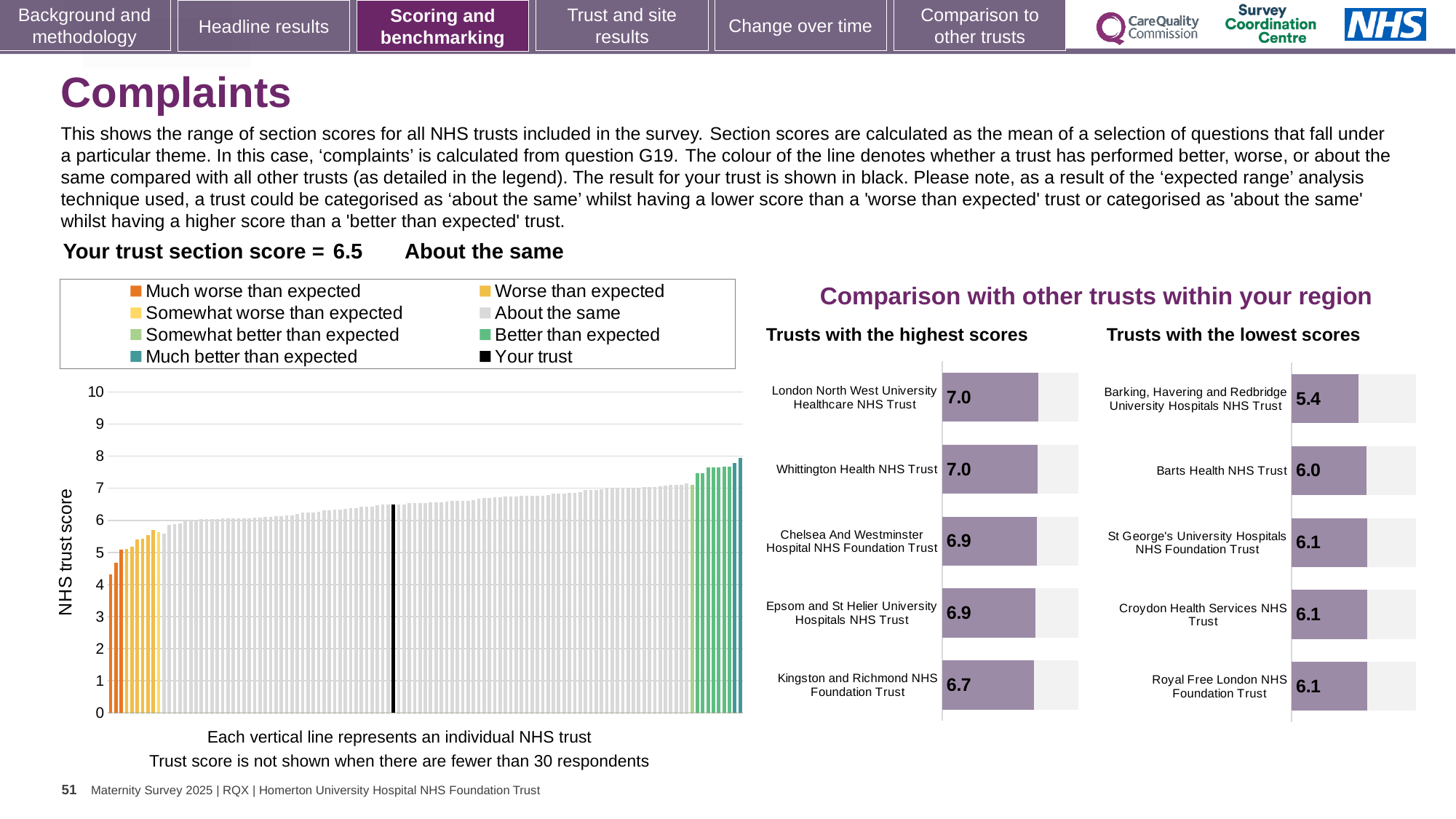
In the large 'NHS trust score' chart on the left, what colour is the bar for your trust? black How many trusts are shown in the 'Trusts with the highest scores' chart? 5 In the large 'NHS trust score' chart on the left, do the trust scores rise or fall from left to right? rise In the 'Trusts with the lowest scores' chart, which trust has the lowest score? Barking, Havering and Redbridge University Hospitals NHS Trust What kind of chart is the large 'NHS trust score' chart on the left of the slide? bar chart In the 'Trusts with the highest scores' chart, which has the higher score: Chelsea And Westminster Hospital NHS Foundation Trust or Kingston and Richmond NHS Foundation Trust? Chelsea And Westminster Hospital NHS Foundation Trust How many entries does the legend of the large 'NHS trust score' chart on the left list? 8 In the 'Trusts with the highest scores' chart, what is the score for Kingston and Richmond NHS Foundation Trust? 6.7 In the 'Trusts with the lowest scores' chart, what is the difference between the scores of Barts Health NHS Trust and Barking, Havering and Redbridge University Hospitals NHS Trust? 0.6 In the large 'NHS trust score' chart on the left, what is the section score for your trust? 6.5 In the 'Trusts with the highest scores' chart, what is the difference between the scores of London North West University Healthcare NHS Trust and Kingston and Richmond NHS Foundation Trust? 0.3 In the 'Trusts with the lowest scores' chart, what is the score for Barts Health NHS Trust? 6.0